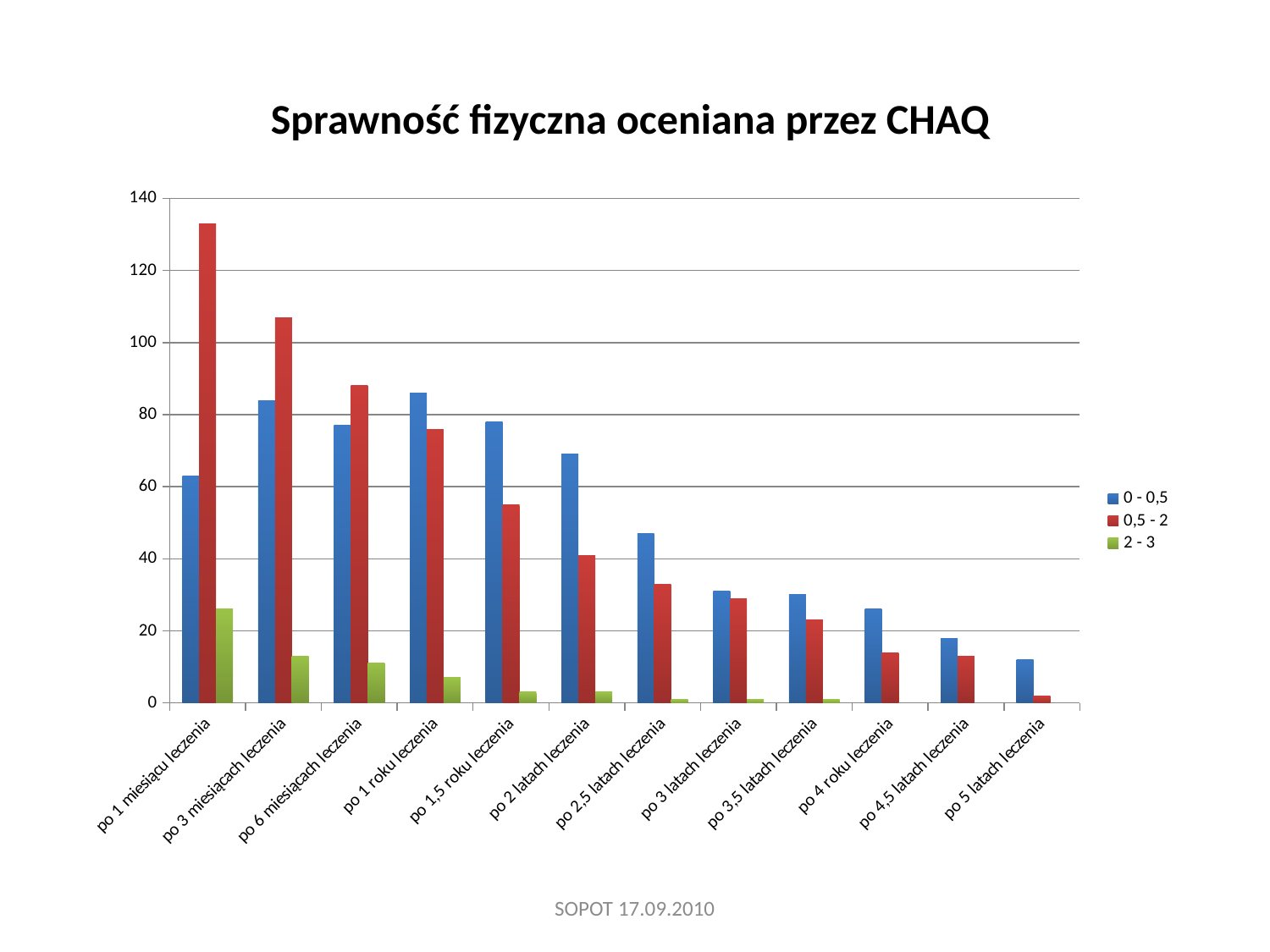
For which category is the value of the "0 - 0,5" series lowest? po 5 latach leczenia What is the title of the chart? Sprawność fizyczna oceniana przez CHAQ Is the value of the "0,5 - 2" series for "po 1 miesiącu leczenia" greater or less than 120? greater For "po 2 latach leczenia", which series has the larger value: "0 - 0,5" or "0,5 - 2"? 0 - 0,5 Is the value of the "0,5 - 2" series for "po 3 miesiącach leczenia" greater or less than 100? greater For which category is the value of the "0,5 - 2" series highest? po 1 miesiącu leczenia Do the values of the "0,5 - 2" series rise or fall along the x axis? fall How many categories are shown on the x axis? 12 Is the value of the "0 - 0,5" series for "po 5 latach leczenia" greater or less than 20? less For "po 1 miesiącu leczenia", which series has the larger value: "0 - 0,5" or "0,5 - 2"? 0,5 - 2 What kind of chart is shown on the slide? bar chart How many series does the legend list? 3